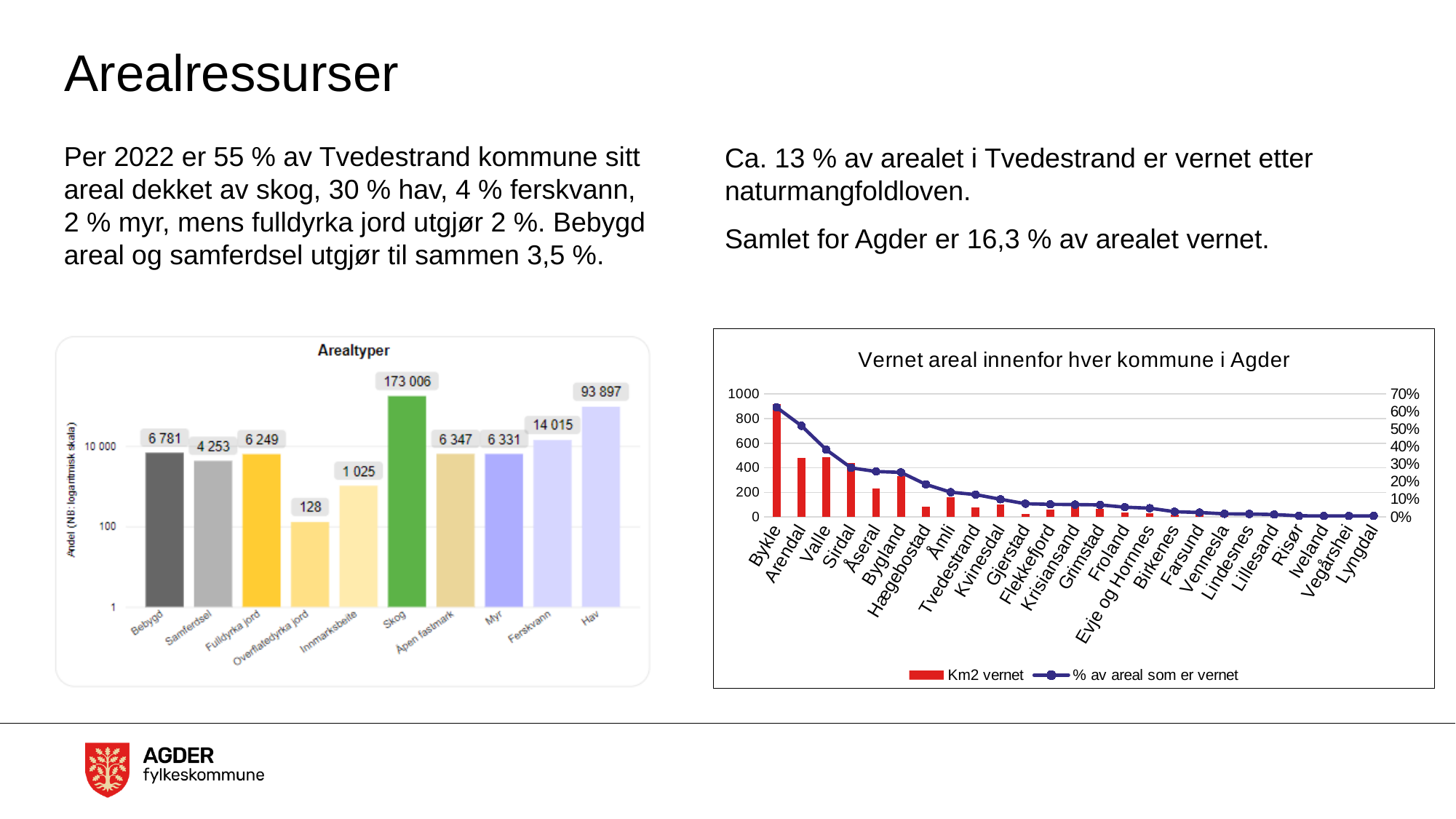
In the Arealtyper chart, which category has the highest value? Skog How many series does the legend list in the chart titled 'Vernet areal innenfor hver kommune i Agder'? 2 In the chart titled 'Vernet areal innenfor hver kommune i Agder', which municipality has the highest Km2 vernet? Bykle In the Arealtyper chart, which is larger, Bebygd or Samferdsel? Bebygd How many categories are shown in the Arealtyper chart? 10 In the chart titled 'Vernet areal innenfor hver kommune i Agder', does the '% av areal som er vernet' line rise or fall from left to right? fall In the Arealtyper chart, what is the value for Skog? 173 006 In the chart titled 'Vernet areal innenfor hver kommune i Agder', is the Km2 vernet value for Bykle greater or less than 800? greater In the Arealtyper chart, what is the difference between the values for Ferskvann and Innmarksbeite? 12 990 In the Arealtyper chart, what is the value for Overflatedyrka jord? 128 In the Arealtyper chart, what is the value for Hav? 93 897 In the Arealtyper chart, which category has the lowest value? Overflatedyrka jord